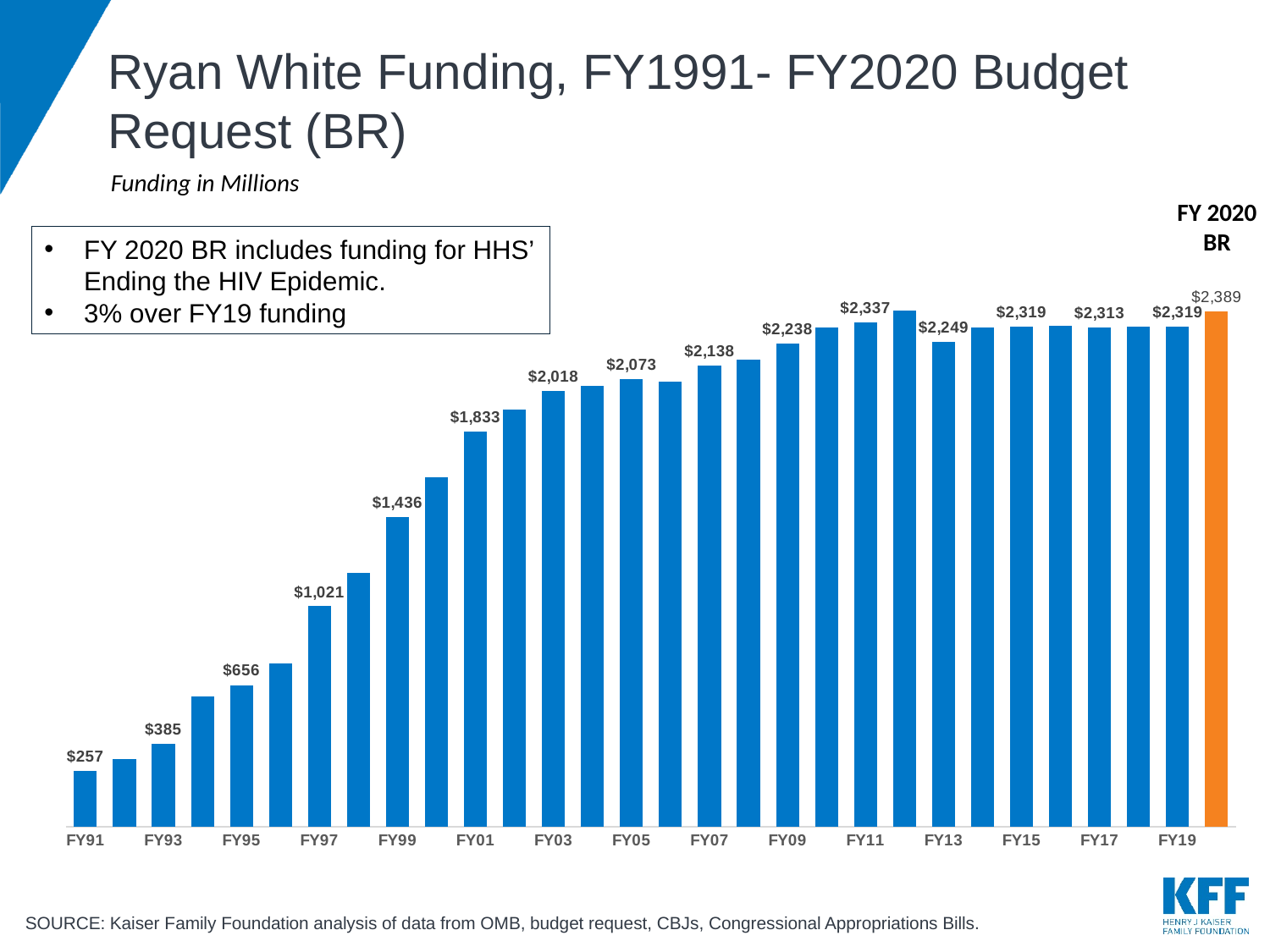
What is the difference between the FY 2020 BR value and the FY19 value? $70 What colour is the FY 2020 BR bar? orange What is the Ryan White funding value shown for FY91? $257 Which fiscal year has the lowest funding value on the chart? FY91 What is the funding value labeled for FY99? $1,436 What is the value shown for the FY 2020 Budget Request bar? $2,389 What type of chart is shown on the slide? bar chart What is the difference between the FY11 and FY13 funding values? $88 What is the funding value labeled for FY11? $2,337 Do the funding values generally rise or fall from FY91 to FY11? rise Which is larger, the funding value for FY11 or for FY13? FY11